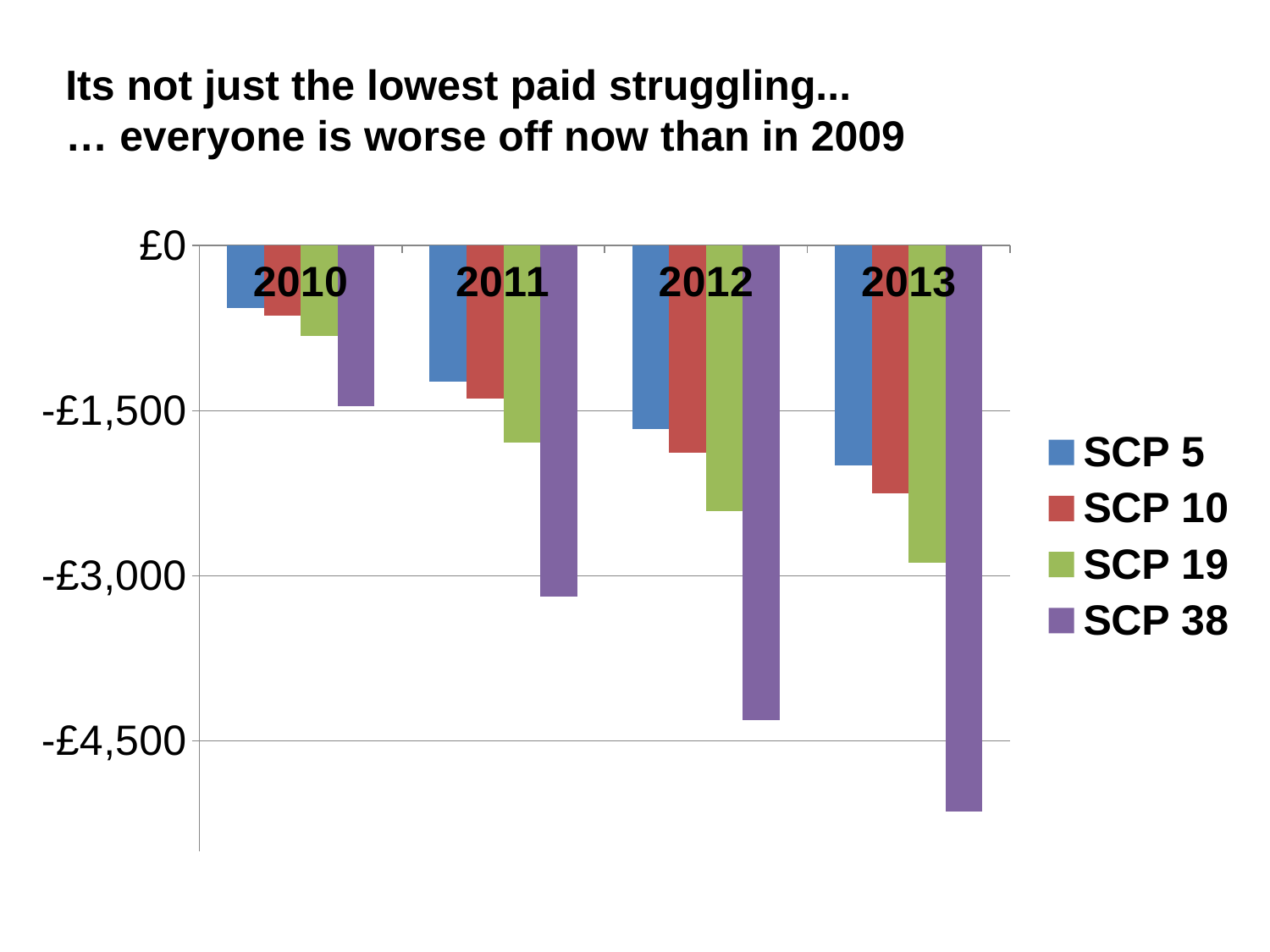
Do the values for SCP 19 rise or fall from 2010 to 2013? Fall For SCP 38, which year has the lowest (most negative) value? 2013 Which series has the lowest (most negative) value in 2013? SCP 38 How many years are shown on the x axis of the chart? 4 How many series does the chart's legend list? 4 Which is larger, the value for SCP 38 in 2012 or the value for SCP 38 in 2013? SCP 38 in 2012 Is the value for SCP 38 in 2013 greater or less than -£4,500? less Is the value for SCP 5 in 2010 greater or less than -£1,500? greater Is the value for SCP 5 in 2013 greater or less than -£1,500? less Which bar on the chart is closest to £0 (the highest value)? SCP 5 in 2010 What kind of chart is shown on the slide? Bar chart